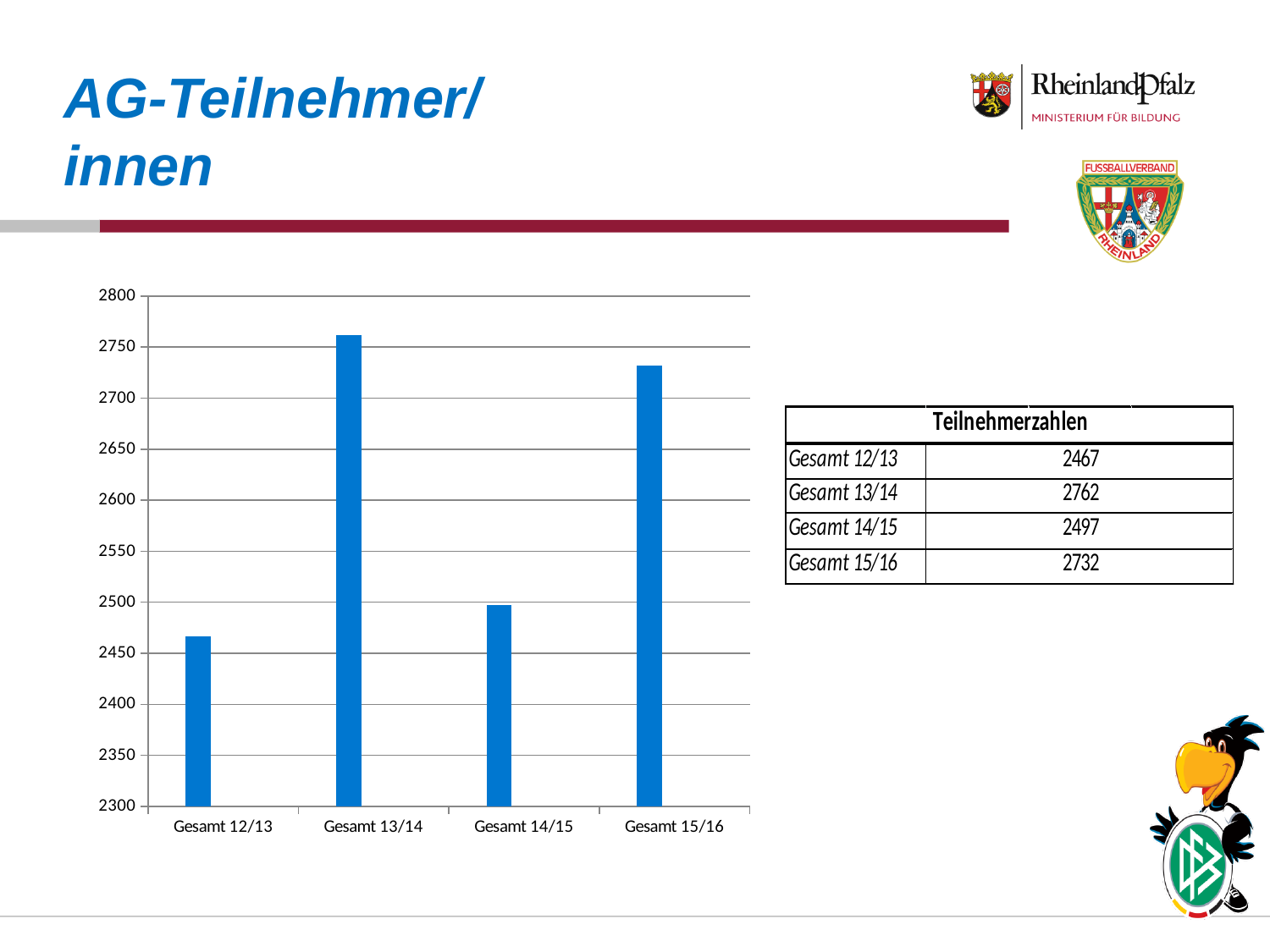
How many categories are shown on the x axis? 4 What is the difference between the values for Gesamt 13/14 and Gesamt 12/13? 295 Is the value for Gesamt 14/15 greater or less than 2600? less What is the title of the table next to the chart? Teilnehmerzahlen Which category has the lowest value? Gesamt 12/13 What is the difference between the values for Gesamt 15/16 and Gesamt 14/15? 235 What kind of chart is shown on the slide? bar chart Which is larger, the value for Gesamt 14/15 or the value for Gesamt 15/16? Gesamt 15/16 What is the value for Gesamt 13/14? 2762 Which category has the highest value? Gesamt 13/14 What is the value for Gesamt 12/13? 2467 What is the value for Gesamt 15/16? 2732